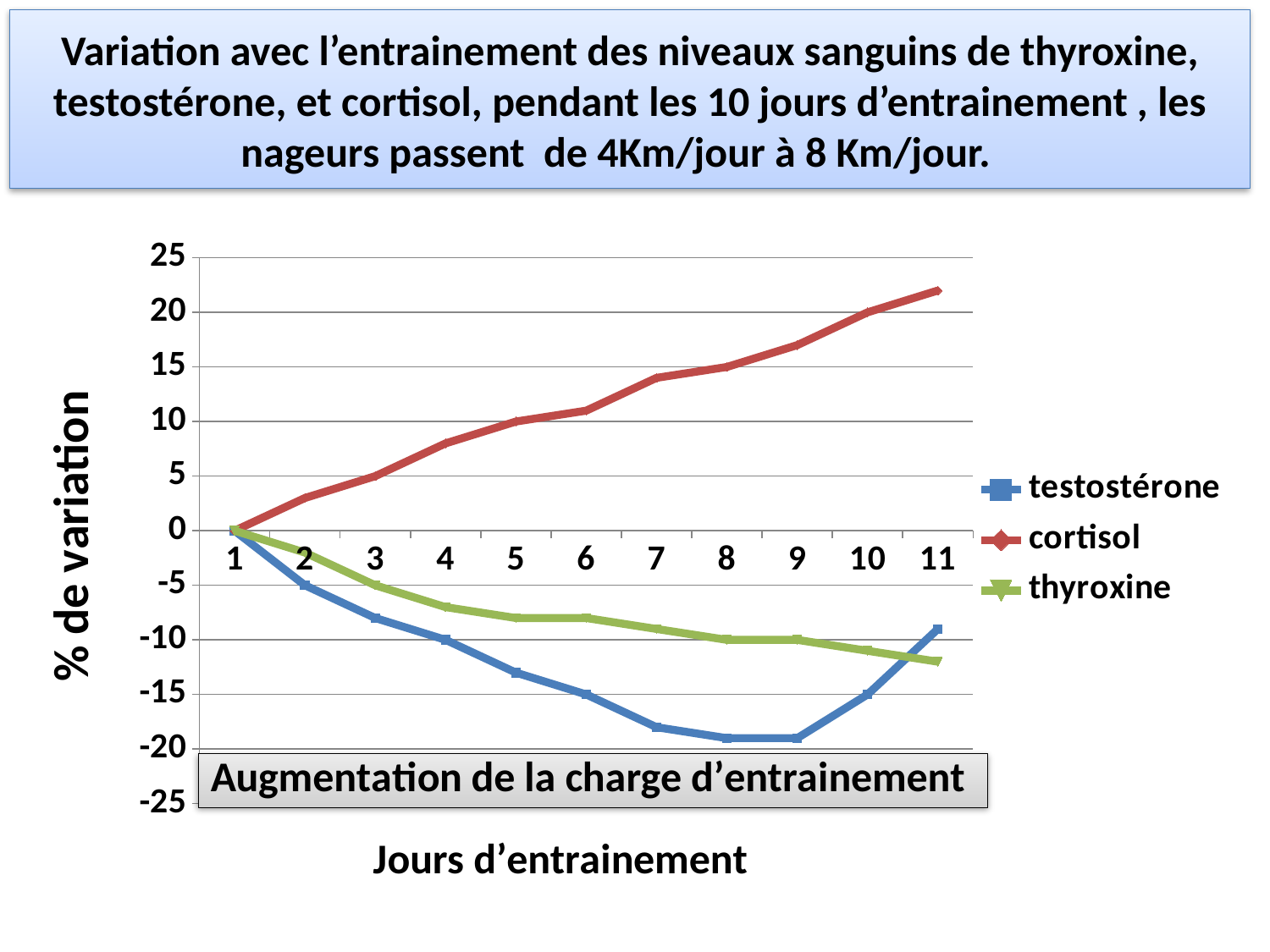
Is the value for cortisol on day 11 greater or less than 20? greater On day 6, which is larger, the value for testostérone or the value for thyroxine? thyroxine Is the value for testostérone on day 8 greater or less than -15? less What is the value for cortisol on day 10? 20 How many series does the legend list? 3 How many training days are plotted along the x axis? 11 What is the value for testostérone on day 4? -10 What is the value for testostérone on day 2? -5 What kind of chart is shown on the slide? line chart Which series has the highest value on day 11? cortisol What is the value for cortisol on day 5? 10 Does the cortisol series rise or fall from day 1 to day 11? rise